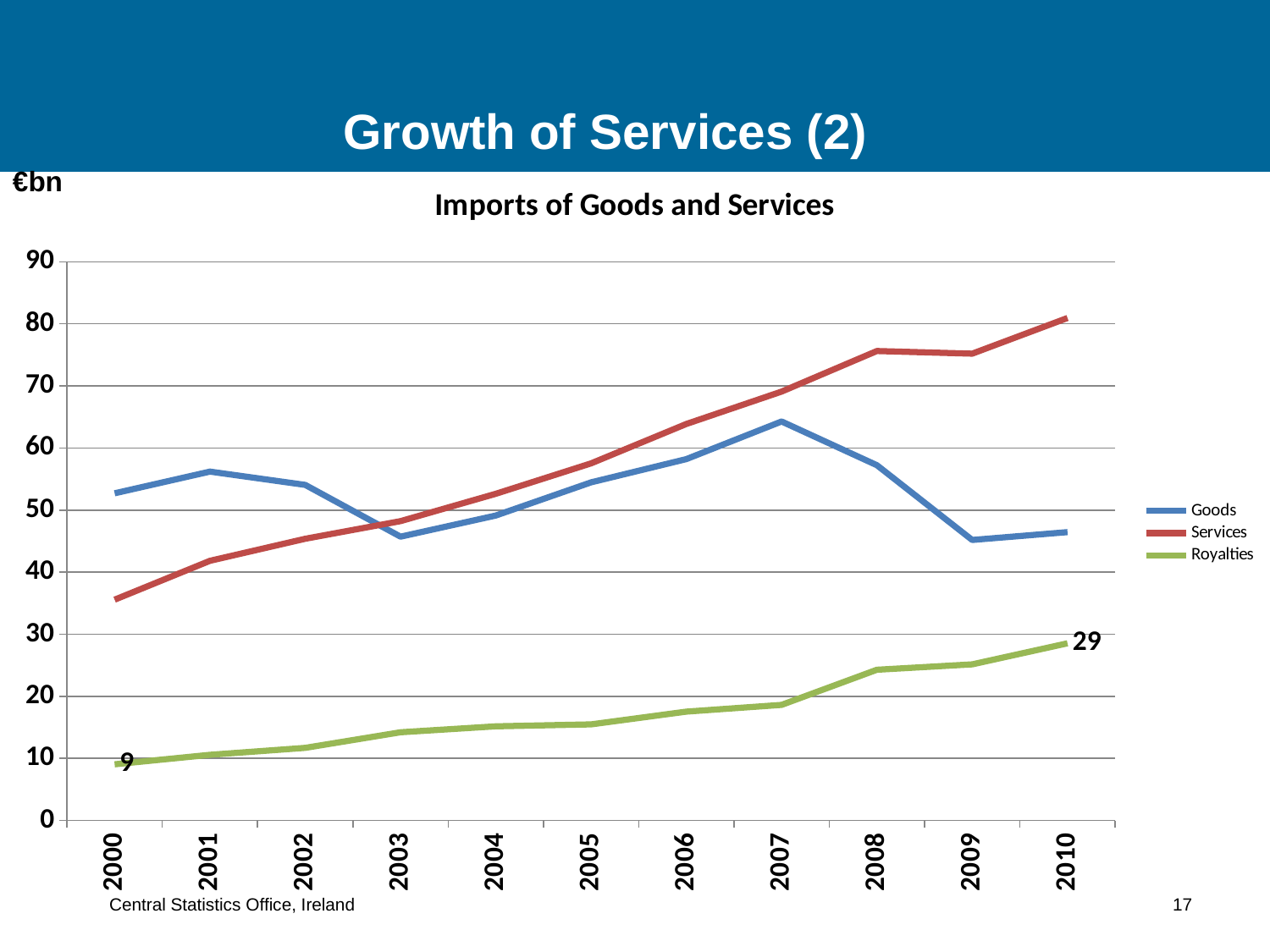
What is the value for Royalties in 2000? 9 How many series does the legend list? 3 What kind of chart is shown on the slide? Line chart Is the value for Services in 2000 greater or less than 40? less In which year does the Goods series reach its highest value? 2007 Is the value for Goods in 2007 greater or less than 60? greater Does the Services series generally rise or fall from 2000 to 2010? Rise What is the title of the chart? Imports of Goods and Services What is the value for Royalties in 2010? 29 By how much did Royalties increase between 2000 and 2010? 20 Which is larger in 2010, Goods or Services? Services How many years are plotted along the x axis? 11